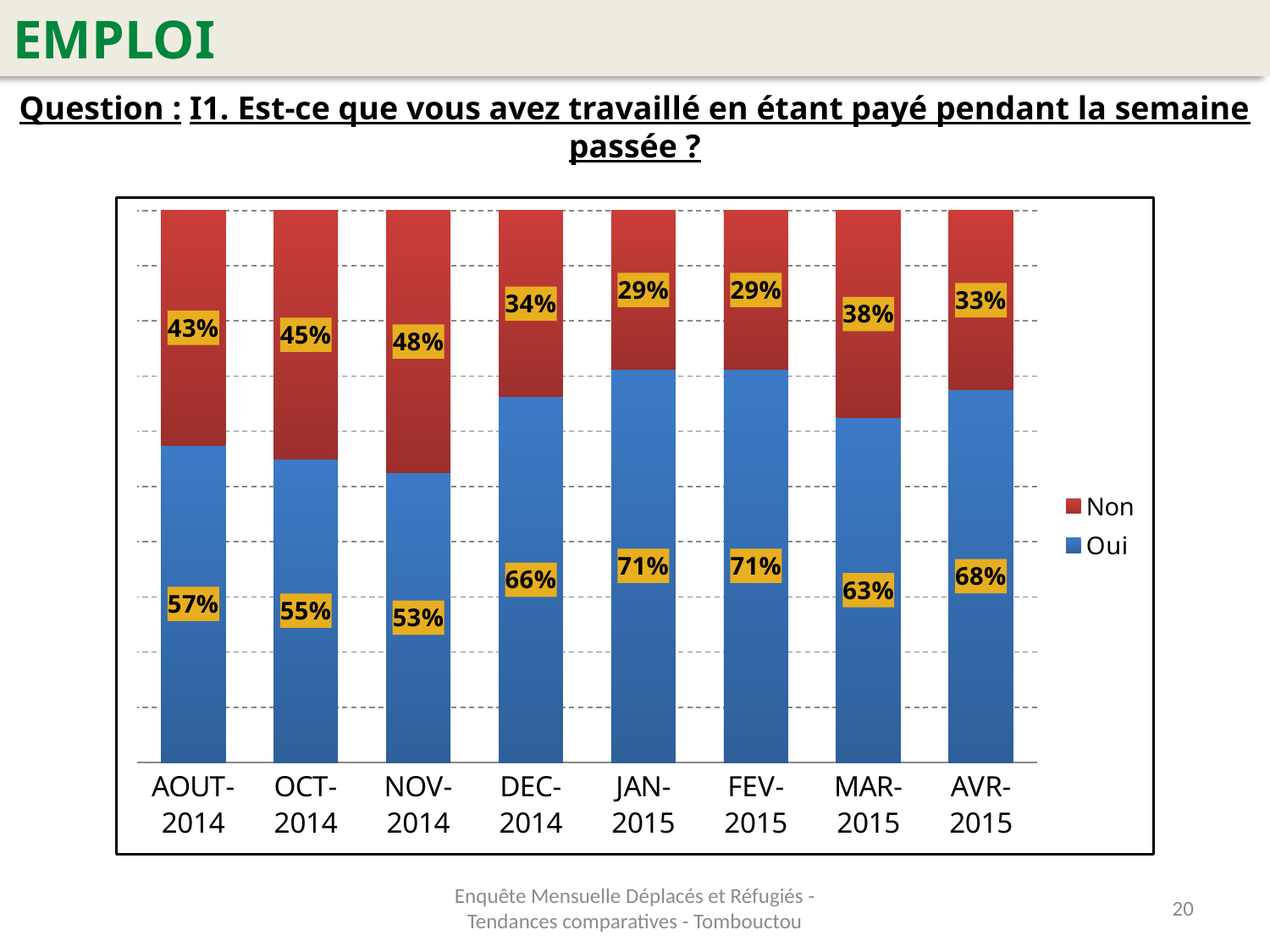
What is the value for Oui in AVR-2015? 68% How many months are shown on the x axis? 8 Which month has the highest value for Non? NOV-2014 Which month has the lowest value for Oui? NOV-2014 How many series does the legend list? 2 What is the difference between the Oui values for FEV-2015 and MAR-2015? 8% Which is larger, the Non value for DEC-2014 or the Non value for MAR-2015? MAR-2015 Which colour represents the Oui series in the legend? Blue What is the value for Oui in JAN-2015? 71% What is the total of the stacked bar for OCT-2014? 100% What is the value for Non in NOV-2014? 48% What kind of chart is shown on the slide? Stacked bar chart